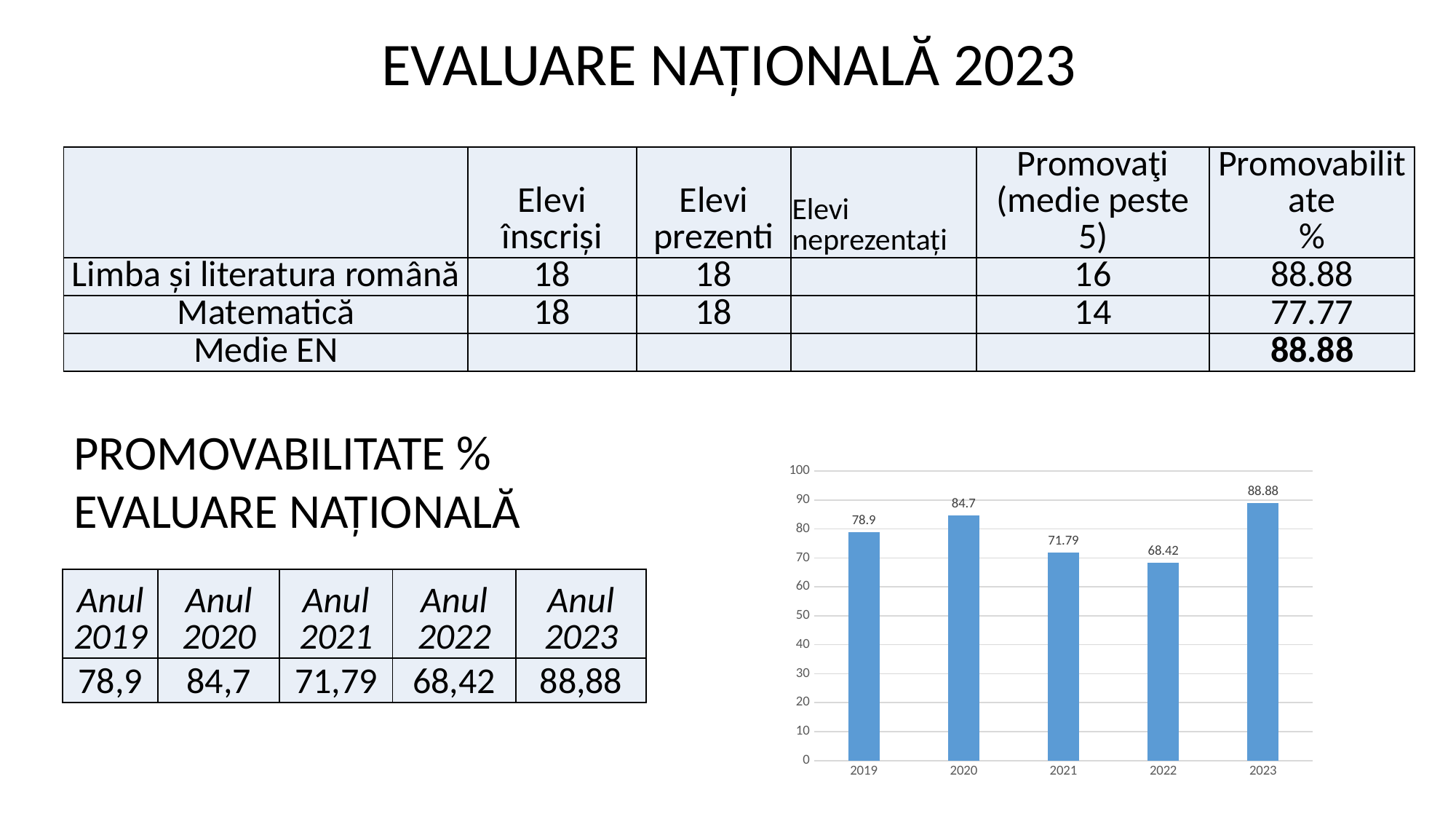
How many bars are shown in the chart? 5 Is the value for 2021 in the bar chart greater or less than 80? less What is the value shown for 2019 in the bar chart? 78.9 Which is larger in the bar chart, the value for 2020 or the value for 2021? 2020 Does the value in the bar chart rise or fall from 2020 to 2022? fall What is the value shown for 2022 in the bar chart? 68.42 What is the value shown for 2021 in the bar chart? 71.79 Which year has the highest bar in the chart? 2023 What is the difference between the values for 2020 and 2019 in the bar chart? 5.8 What is the difference between the values for 2023 and 2022 in the bar chart? 20.46 What kind of chart is shown on the slide? bar chart Which year has the lowest bar in the chart? 2022